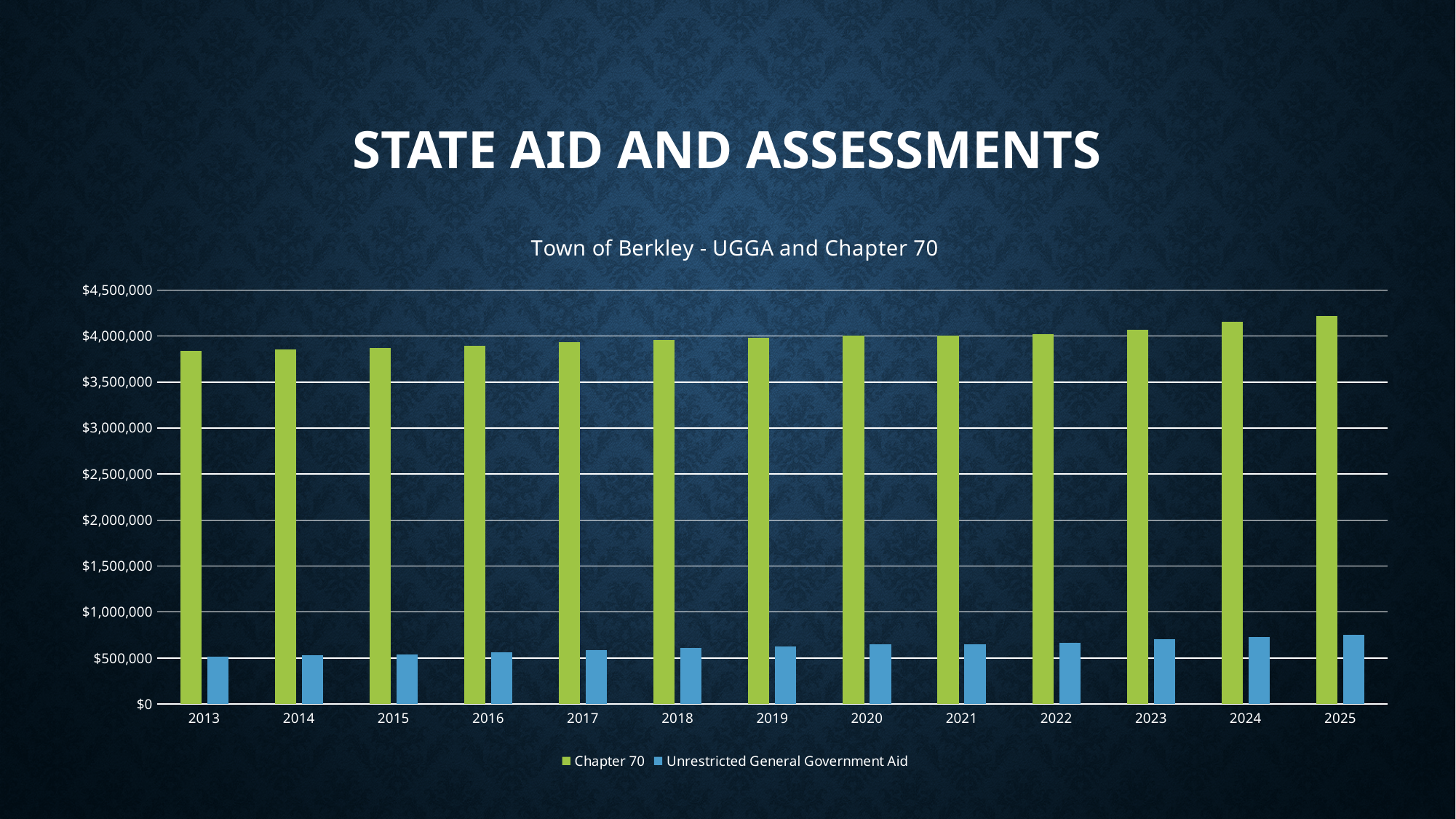
Is the Chapter 70 value for 2025 greater or less than $4,000,000? greater Do the Chapter 70 values rise or fall from 2013 to 2025? Rise Which is larger in 2020, Chapter 70 or Unrestricted General Government Aid? Chapter 70 Is the Unrestricted General Government Aid value for 2025 greater or less than $1,000,000? less How many years are shown on the x axis? 13 Which year has the highest Chapter 70 value? 2025 How many series does the legend list? 2 Which year has the lowest Chapter 70 value? 2013 Is the Chapter 70 value for 2013 greater or less than $4,000,000? less Which year has the lowest Unrestricted General Government Aid value? 2013 What kind of chart is shown on the slide? Bar chart Which year has the highest Unrestricted General Government Aid value? 2025